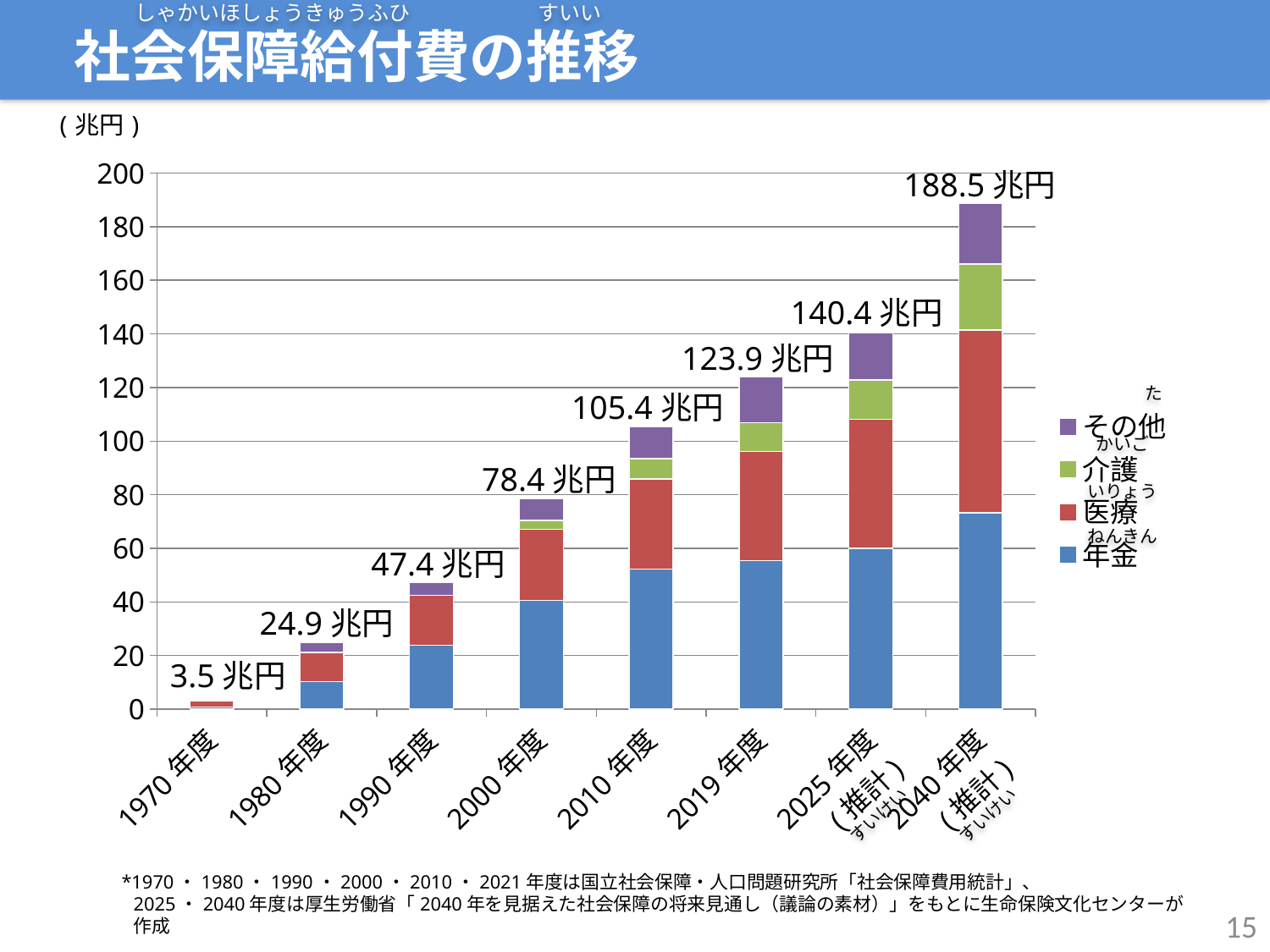
What kind of chart is shown on the slide? Stacked bar chart What is the difference between the total for 2040年度（推計） and the total for 2025年度（推計）? 48.1 兆円 Which is larger, the total for 2000年度 or the total for 2010年度? 2010年度 How many fiscal years are shown on the x axis? 8 Is the 年金 (pension) portion of the 1990年度 bar greater or less than 40? less What is the total value labeled for 2040年度（推計）? 188.5 兆円 Which fiscal year has the highest total social security benefit expenditure? 2040年度（推計） Do the total values rise or fall from 1970年度 to 2040年度（推計）? Rise Which fiscal year has the lowest total social security benefit expenditure? 1970年度 How many series does the legend list? 4 What is the total social security benefit expenditure shown for 2019年度? 123.9 兆円 Is the 年金 (pension) portion of the 2040年度（推計） bar greater or less than 60? greater